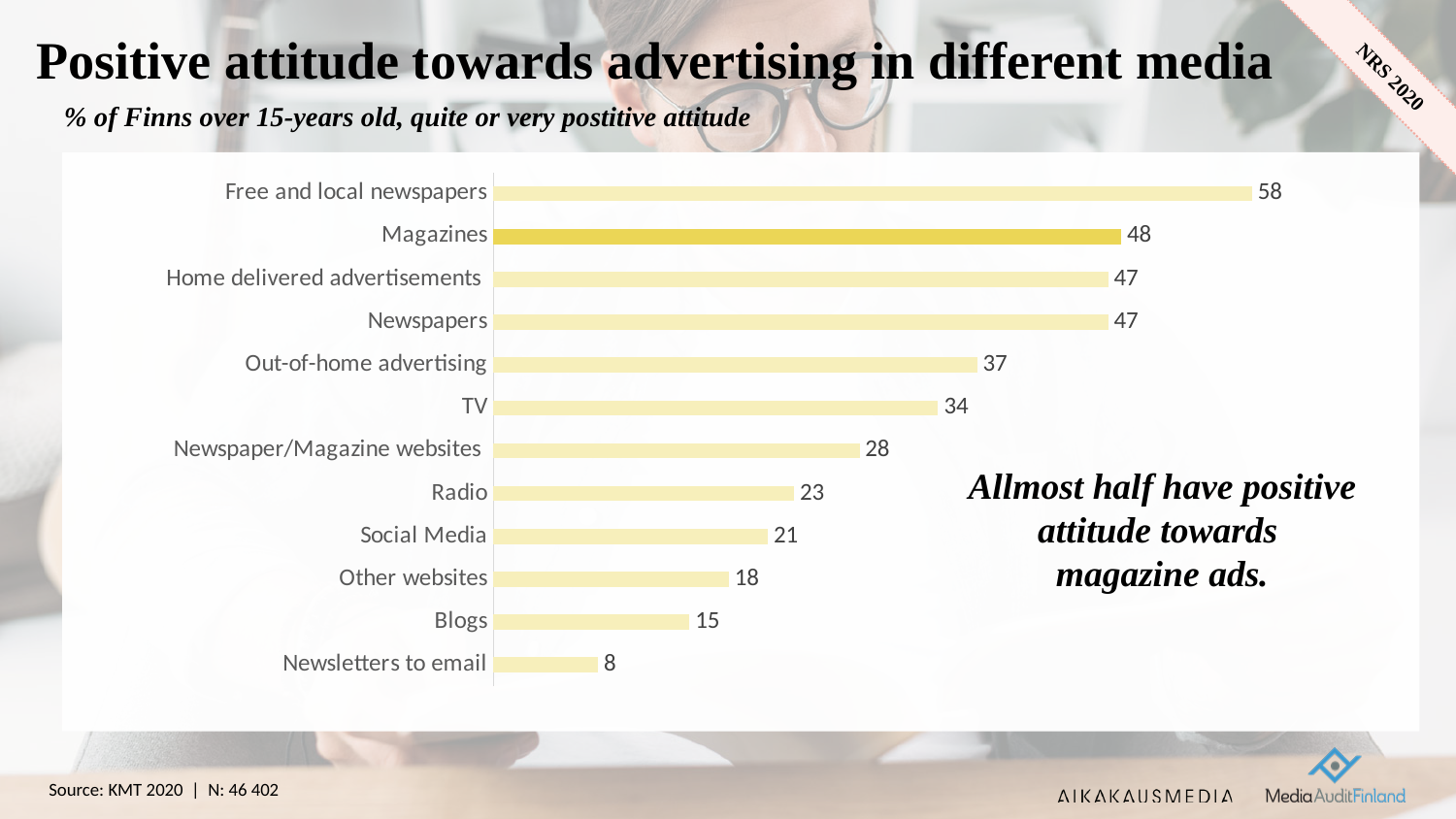
What kind of chart is shown on the slide? Bar chart What is the value for Magazines? 48 What is the value for Newsletters to email? 8 How many categories are shown in the chart? 12 Which bar is highlighted in a darker yellow colour than the others? Magazines Which category has the highest value? Free and local newspapers Which category has the lowest value? Newsletters to email Which is larger, the value for Out-of-home advertising or the value for Social Media? Out-of-home advertising What is the difference between the values for Free and local newspapers and Magazines? 10 What is the difference between the values for Radio and Blogs? 8 What is the title of the chart? Positive attitude towards advertising in different media What is the value for TV? 34